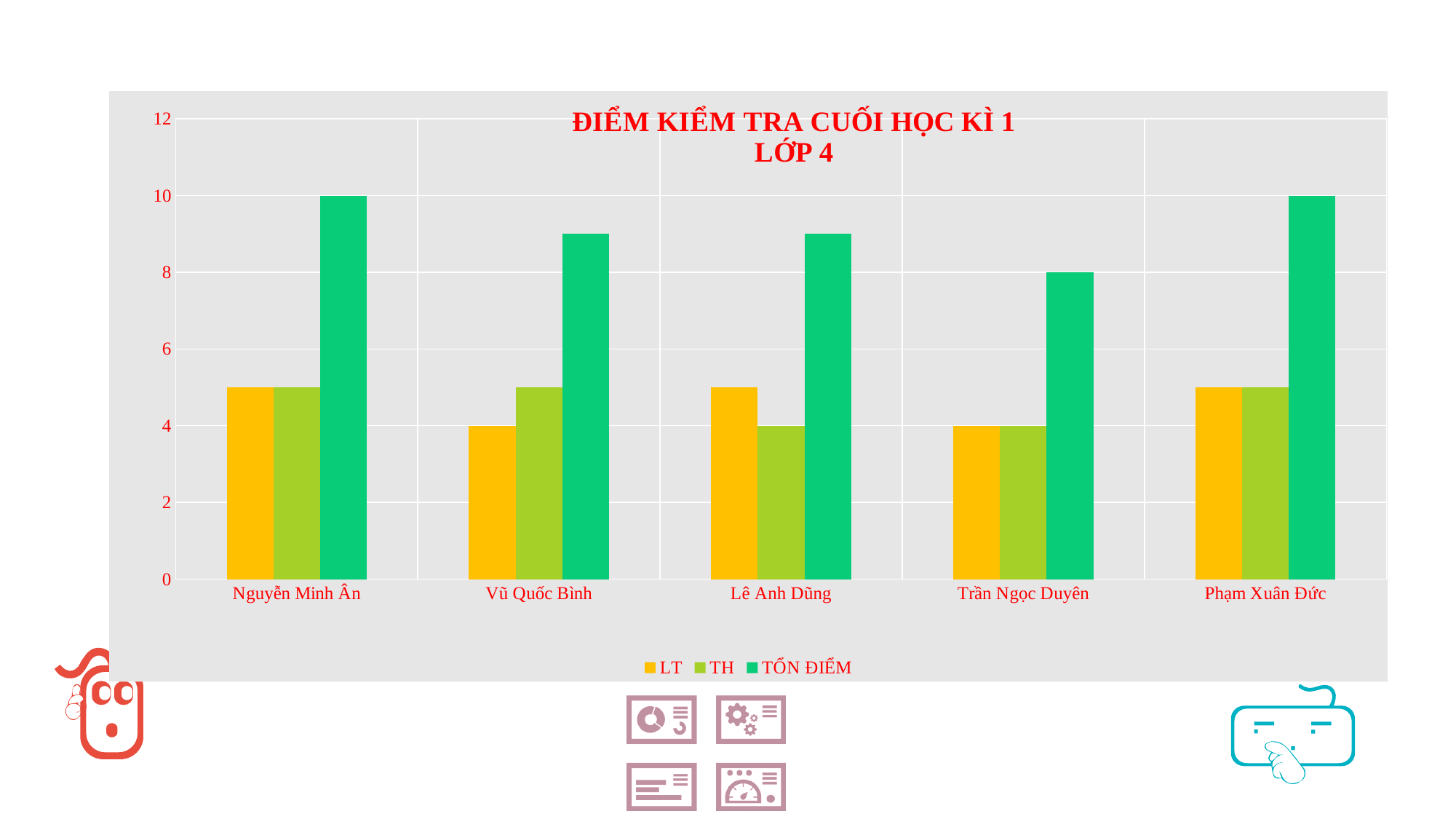
What kind of chart is shown on the slide? bar chart What is the TỔN ĐIỂM value for Trần Ngọc Duyên? 8 Which student has the lowest TỔN ĐIỂM? Trần Ngọc Duyên What is the TỔN ĐIỂM value for Nguyễn Minh Ân? 10 How many series does the legend list? 3 Which is larger, the TỔN ĐIỂM of Vũ Quốc Bình or of Trần Ngọc Duyên? Vũ Quốc Bình What is the difference between the TỔN ĐIỂM of Phạm Xuân Đức and Trần Ngọc Duyên? 2 What is the TH value for Lê Anh Dũng? 4 What is the LT value for Vũ Quốc Bình? 4 How many students are shown on the x axis? 5 Is the LT value for Nguyễn Minh Ân greater or less than 6? less Is the TỔN ĐIỂM value for Lê Anh Dũng greater or less than 8? greater